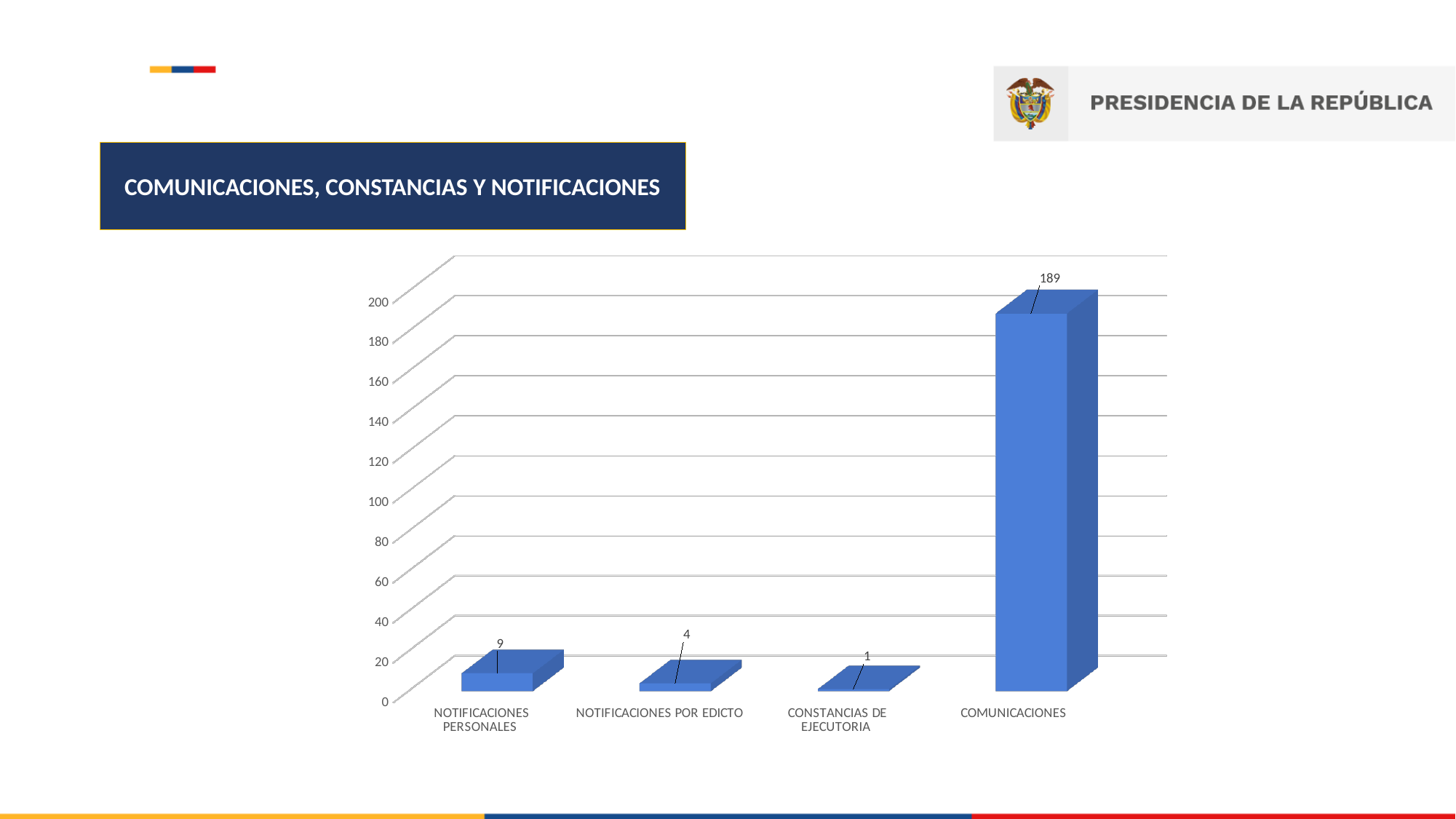
What is the value for CONSTANCIAS DE EJECUTORIA? 1 What kind of chart is shown on the slide? Bar chart What is the value for NOTIFICACIONES POR EDICTO? 4 How many categories are shown on the chart? 4 What is the value for NOTIFICACIONES PERSONALES? 9 Which category has the lowest value? CONSTANCIAS DE EJECUTORIA What is the value for COMUNICACIONES? 189 What is the difference between the values for COMUNICACIONES and NOTIFICACIONES PERSONALES? 180 Which is larger, the value for NOTIFICACIONES POR EDICTO or the value for CONSTANCIAS DE EJECUTORIA? NOTIFICACIONES POR EDICTO Which category has the highest value? COMUNICACIONES What is the difference between the values for NOTIFICACIONES PERSONALES and NOTIFICACIONES POR EDICTO? 5 What is the title shown above the chart? COMUNICACIONES, CONSTANCIAS Y NOTIFICACIONES